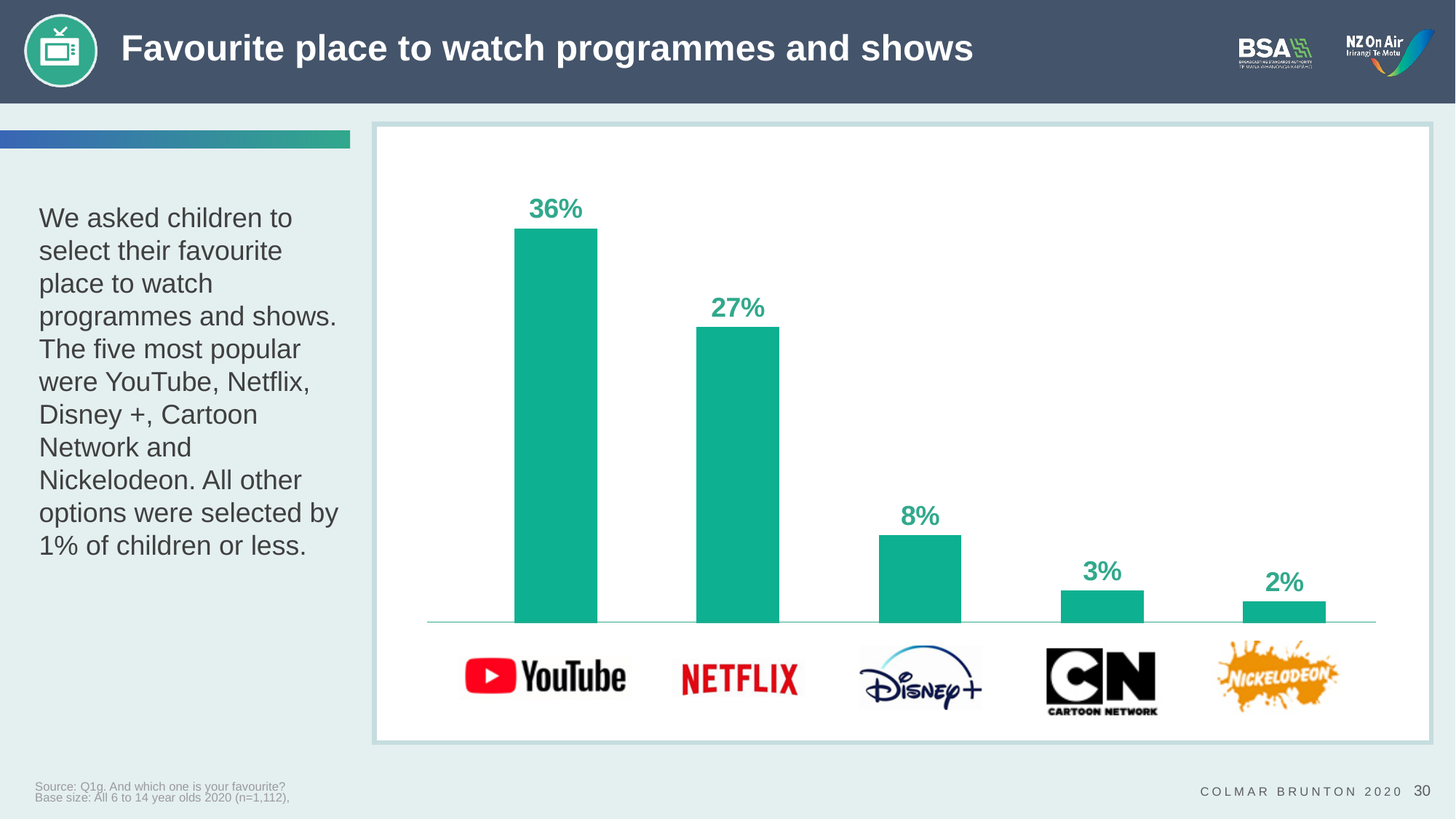
What is the difference in percentage points between Netflix and Disney+? 19 Which place to watch programmes and shows has the highest percentage in the chart? YouTube Which has a higher percentage, Disney+ or Cartoon Network? Disney+ What value is shown for Disney+ in the chart? 8% What percentage of children chose Netflix as their favourite place to watch programmes and shows? 27% Which place to watch programmes and shows has the lowest percentage in the chart? Nickelodeon What is the difference in percentage points between YouTube and Netflix? 9 What value is shown for Nickelodeon in the chart? 2% What type of chart is used on this slide? Bar chart What percentage of children chose YouTube as their favourite place to watch programmes and shows? 36% What value is shown for Cartoon Network in the chart? 3% How many places to watch programmes and shows are shown in the chart? 5